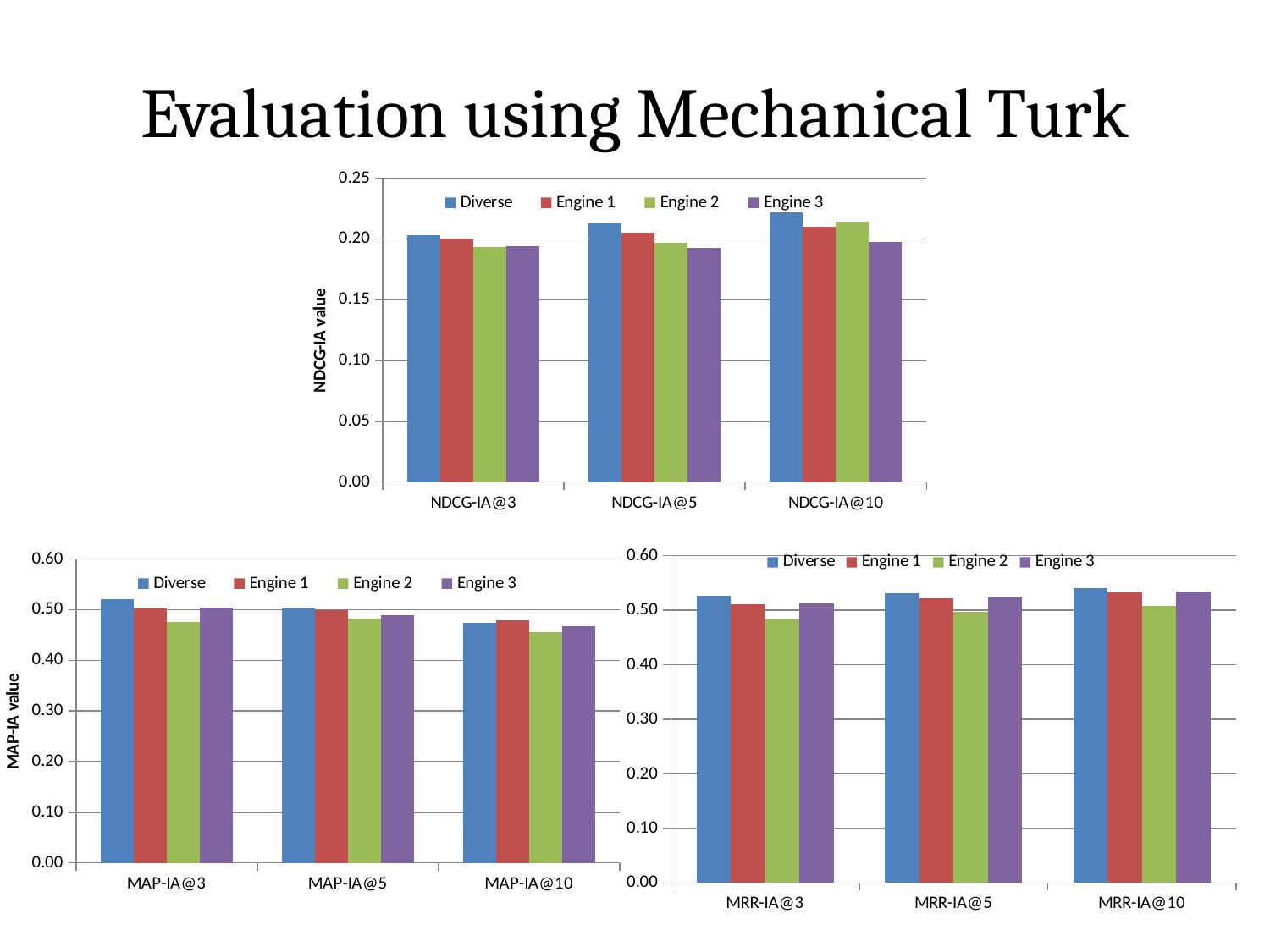
In the top chart (NDCG-IA value), which series has the lowest value at NDCG-IA@10? Engine 3 In the top chart (NDCG-IA value), how many series does the legend list? 4 In the top chart (NDCG-IA value), is the value for Engine 3 at NDCG-IA@5 greater or less than 0.20? less In the bottom-right chart (MRR-IA), which is larger at MRR-IA@5: Diverse or Engine 2? Diverse In the top chart (NDCG-IA value), how many categories are shown on the x axis? 3 In the bottom-right chart (MRR-IA), is the value for Diverse at MRR-IA@10 greater or less than 0.50? greater In the bottom-left chart (MAP-IA value), is the value for Engine 2 at MAP-IA@10 greater or less than 0.50? less In the top chart (NDCG-IA value), do the Diverse values rise or fall from NDCG-IA@3 to NDCG-IA@10? rise What is the y-axis title of the bottom-left chart? MAP-IA value What kind of chart is the top chart (NDCG-IA value)? bar chart In the bottom-left chart (MAP-IA value), which series has the lowest value at MAP-IA@3? Engine 2